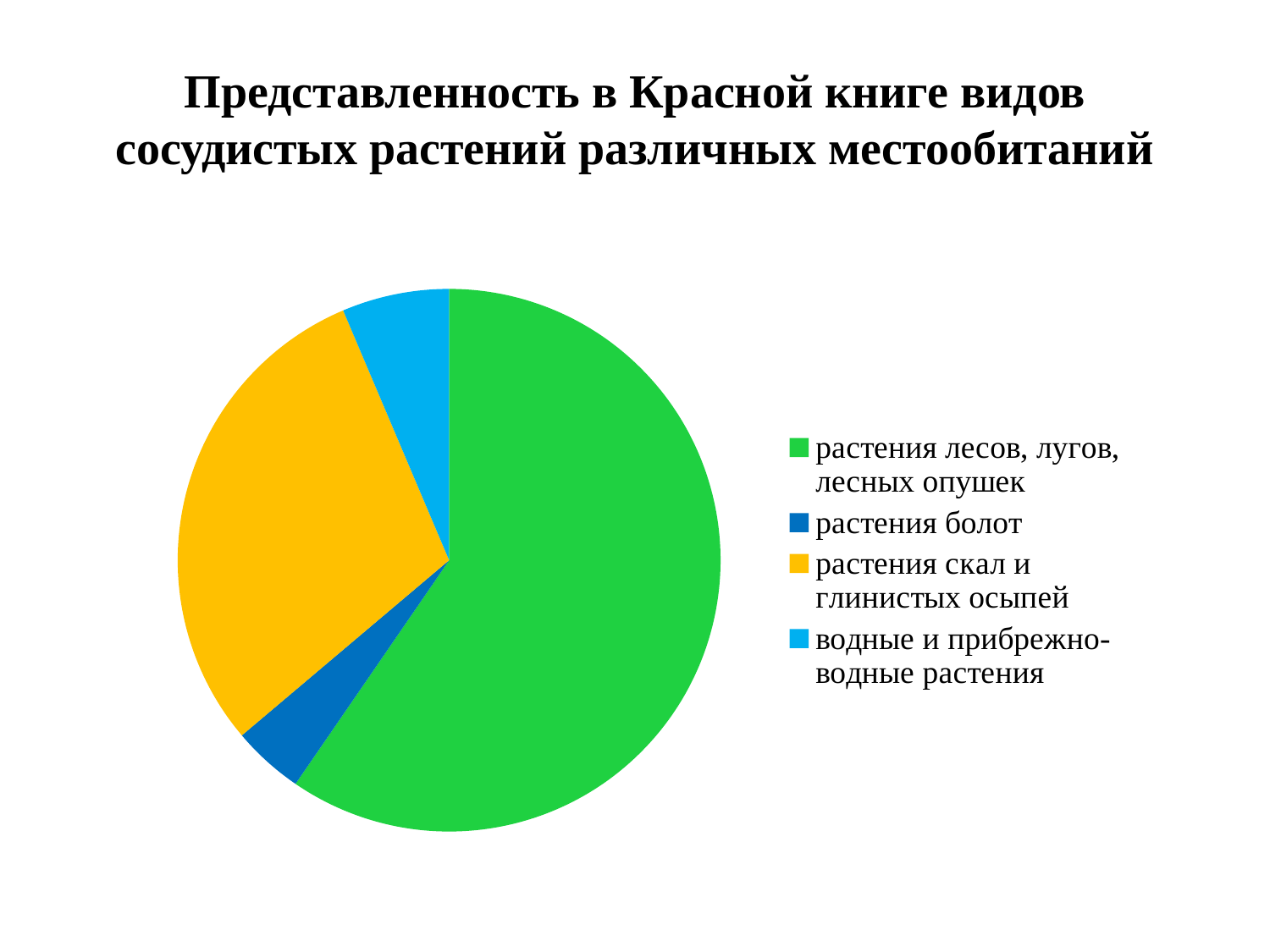
Which slice is larger: растения лесов, лугов, лесных опушек or растения скал и глинистых осыпей? растения лесов, лугов, лесных опушек What kind of chart is shown on the slide? pie chart Which category has the smallest slice of the pie? растения болот How many entries does the legend list? 4 What colour is the slice for растения скал и глинистых осыпей? yellow Does the slice for растения лесов, лугов, лесных опушек take up more or less than half of the pie? more What is the title of the chart on the slide? Представленность в Красной книге видов сосудистых растений различных местообитаний How many categories (slices) does the pie chart have? 4 Which slice is larger: растения болот or водные и прибрежно-водные растения? водные и прибрежно-водные растения Which category has the largest slice of the pie? растения лесов, лугов, лесных опушек